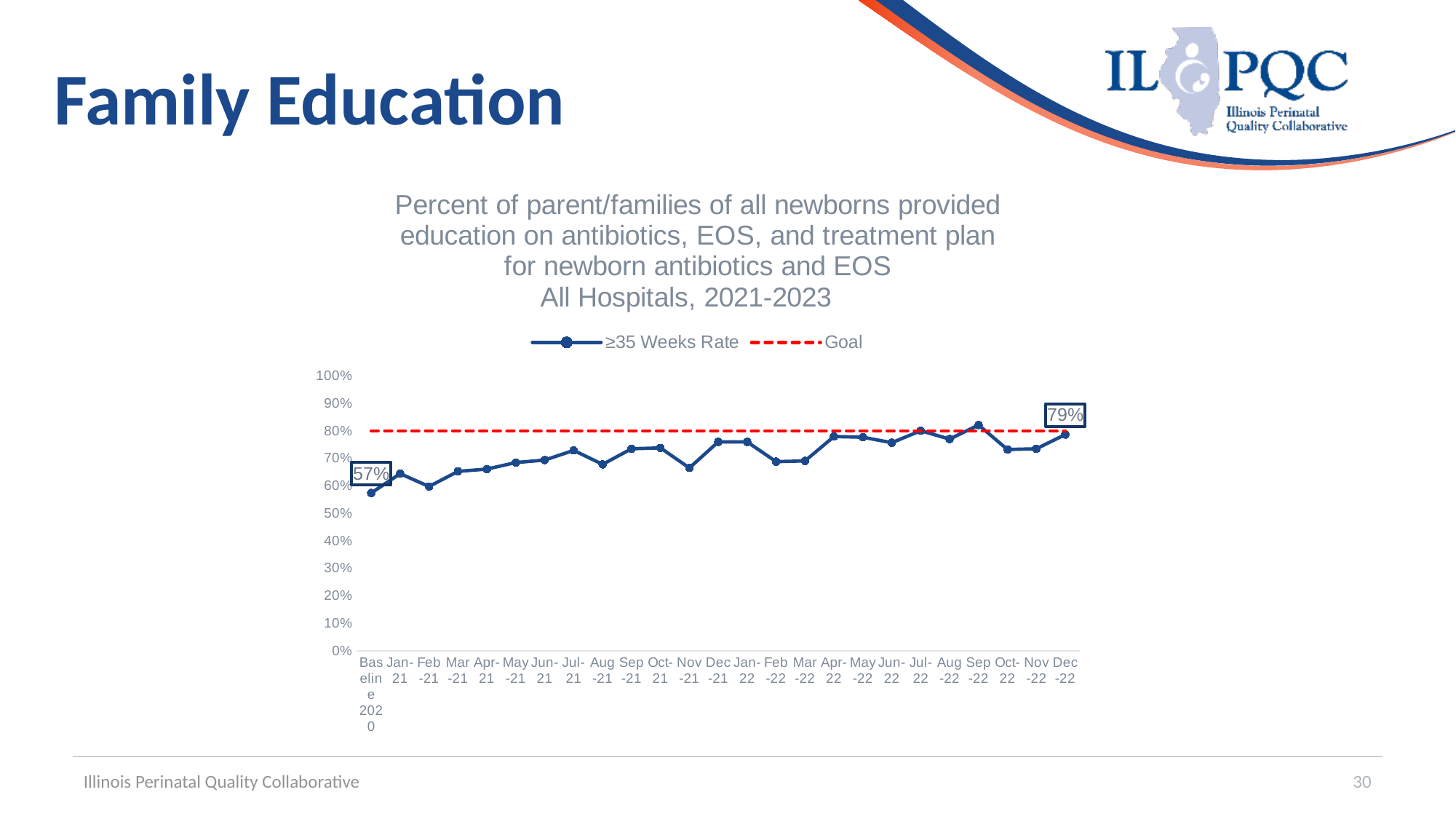
What type of chart is shown on the slide? line chart Is the ≥35 Weeks Rate for Dec-21 greater or less than 70%? greater At what percentage is the Goal line drawn? 80% Which is larger, the rate at Baseline 2020 or the rate at Dec-22? Dec-22 What is the ≥35 Weeks Rate for Dec-22? 79% Is the ≥35 Weeks Rate for Feb-21 greater or less than 70%? less What is the ≥35 Weeks Rate at Baseline 2020? 57% Does the ≥35 Weeks Rate generally rise or fall from Baseline 2020 to Dec-22? rise Which month has the highest ≥35 Weeks Rate? Sep-22 Which time point has the lowest ≥35 Weeks Rate? Baseline 2020 What is the difference between the Dec-22 rate and the Baseline 2020 rate? 22 percentage points How many series does the legend list? 2